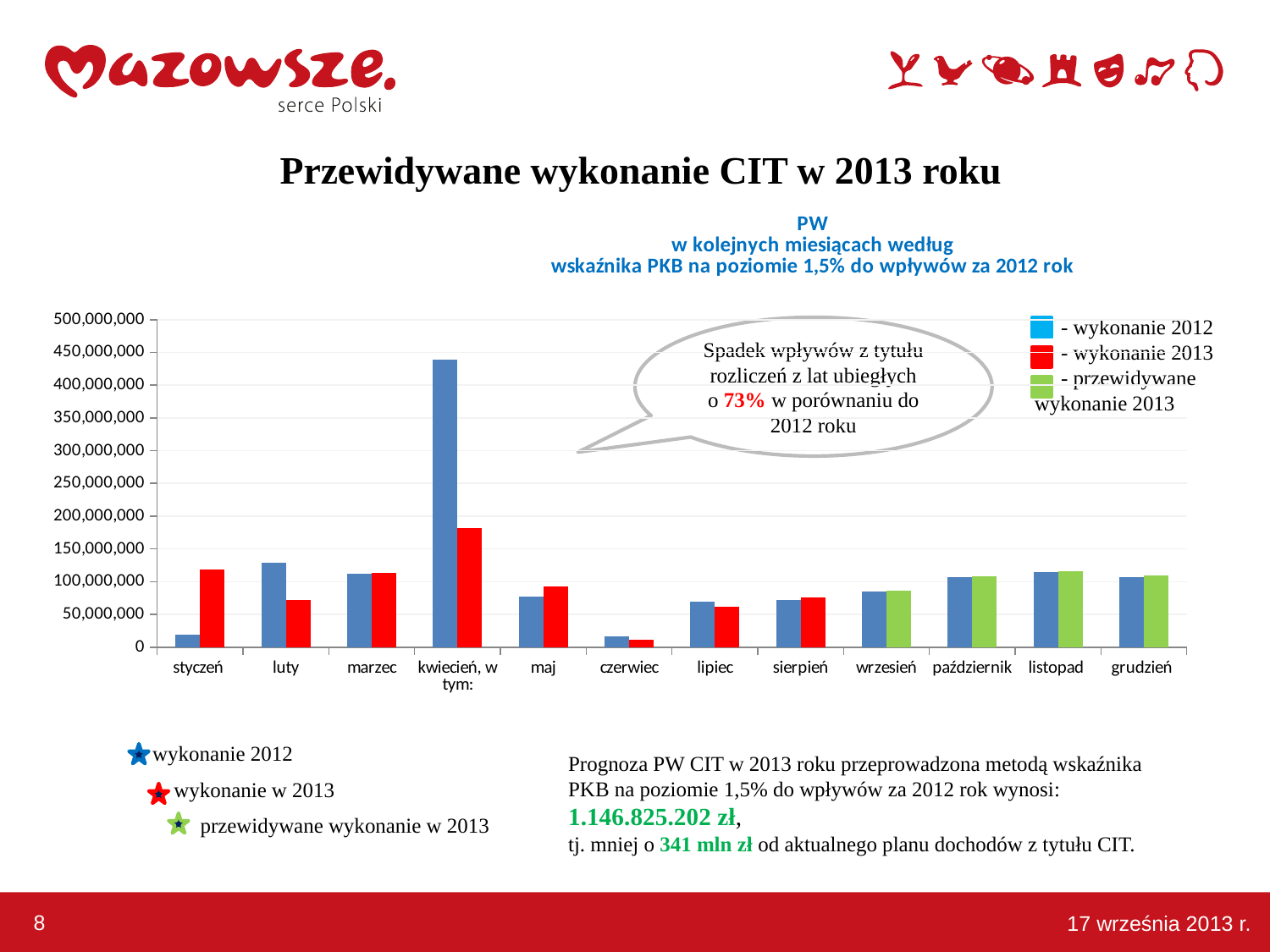
Is the 'wykonanie 2012' value for kwiecień greater or less than 400,000,000? greater Which colour represents 'przewidywane wykonanie 2013' in the chart legend? green What kind of chart is shown on the slide? bar chart Is the 'wykonanie 2013' value for luty greater or less than 100,000,000? less For styczeń, which is larger: 'wykonanie 2012' or 'wykonanie 2013'? wykonanie 2013 For kwiecień, which is larger: 'wykonanie 2012' or 'wykonanie 2013'? wykonanie 2012 How many months (categories) are shown on the x axis of the chart? 12 Which month has the highest 'wykonanie 2012' bar? kwiecień, w tym: Is the 'wykonanie 2012' value for styczeń greater or less than 50,000,000? less How many series does the chart legend list? 3